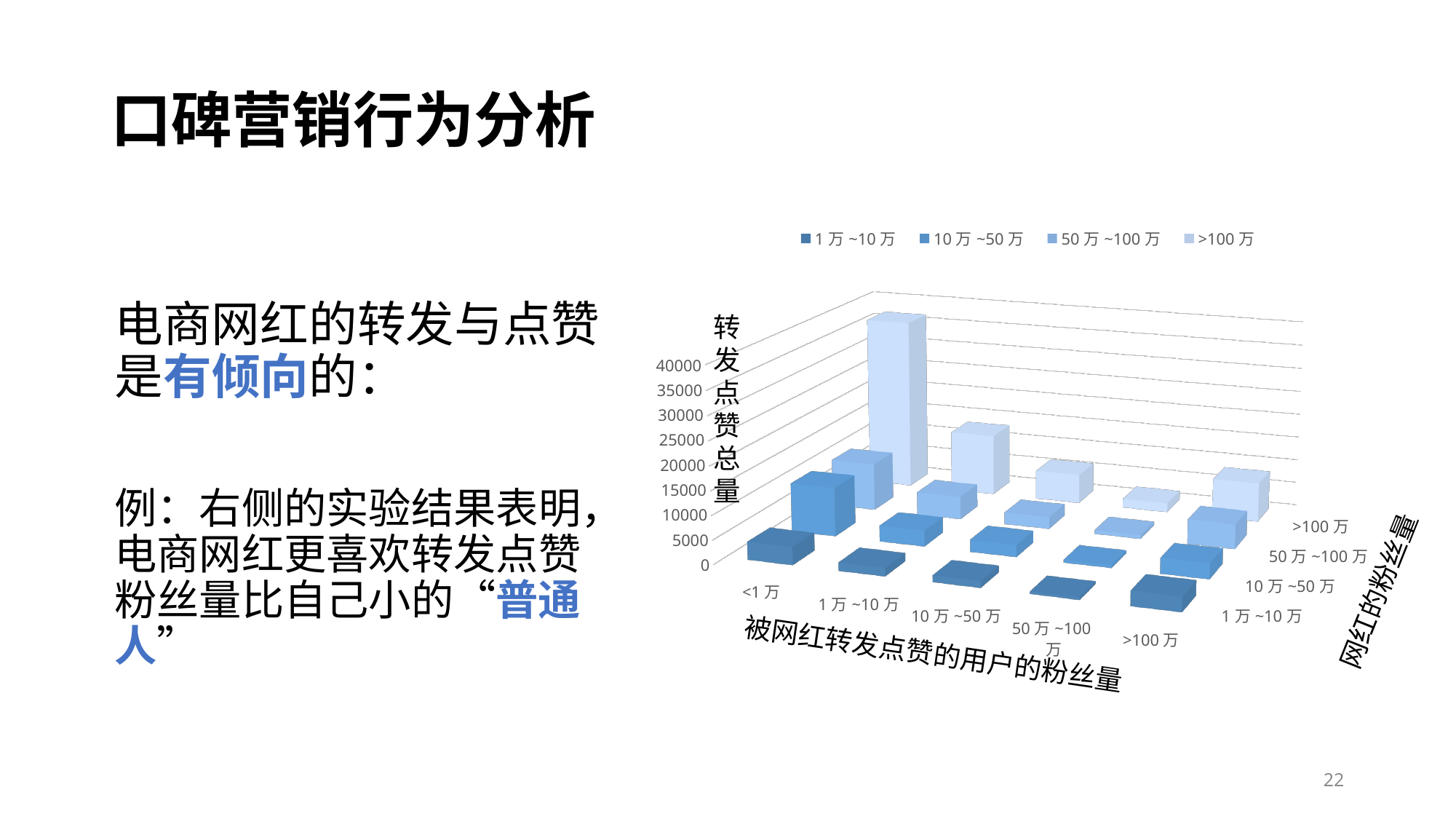
For the >100 万 series, which is larger: the bar at 1 万 ~10 万 or the bar at 10 万 ~50 万? 1 万 ~10 万 For the >100 万 series, which x-axis category has the tallest bar? <1 万 What is the first entry listed in the chart legend? 1 万 ~10 万 How many categories are shown along the x axis of the chart? 5 How many series does the legend list? 4 Which series has the tallest bar in the chart? >100 万 What is the title of the vertical axis of the chart? 转发点赞总量 What is the first category on the x axis of the chart? <1 万 What is the highest tick value shown on the vertical axis? 40000 What kind of chart is shown on the slide? bar chart